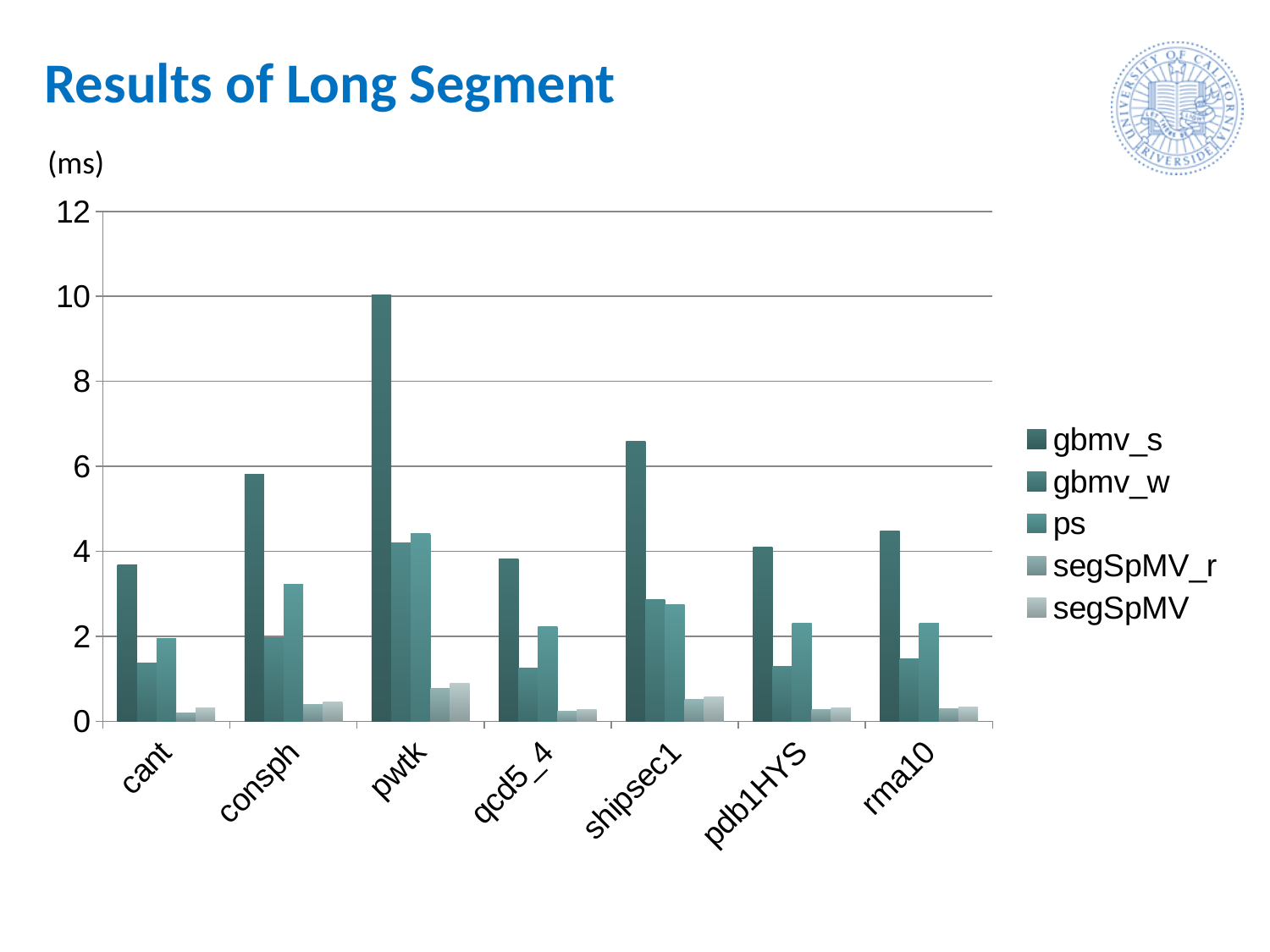
How many categories are shown on the x axis? 7 Which series has the lowest value for pwtk? segSpMV_r Which category has the highest gbmv_s value? pwtk What is the title of the slide? Results of Long Segment What unit is indicated for the y axis? ms Is the gbmv_s value for shipsec1 greater or less than 6? greater Is the gbmv_s value for pwtk greater or less than 8? greater How many series does the legend list? 5 Is the ps value for pwtk greater or less than 4? greater What kind of chart is shown on the slide? bar chart Which is larger, the gbmv_s value for consph or for shipsec1? shipsec1